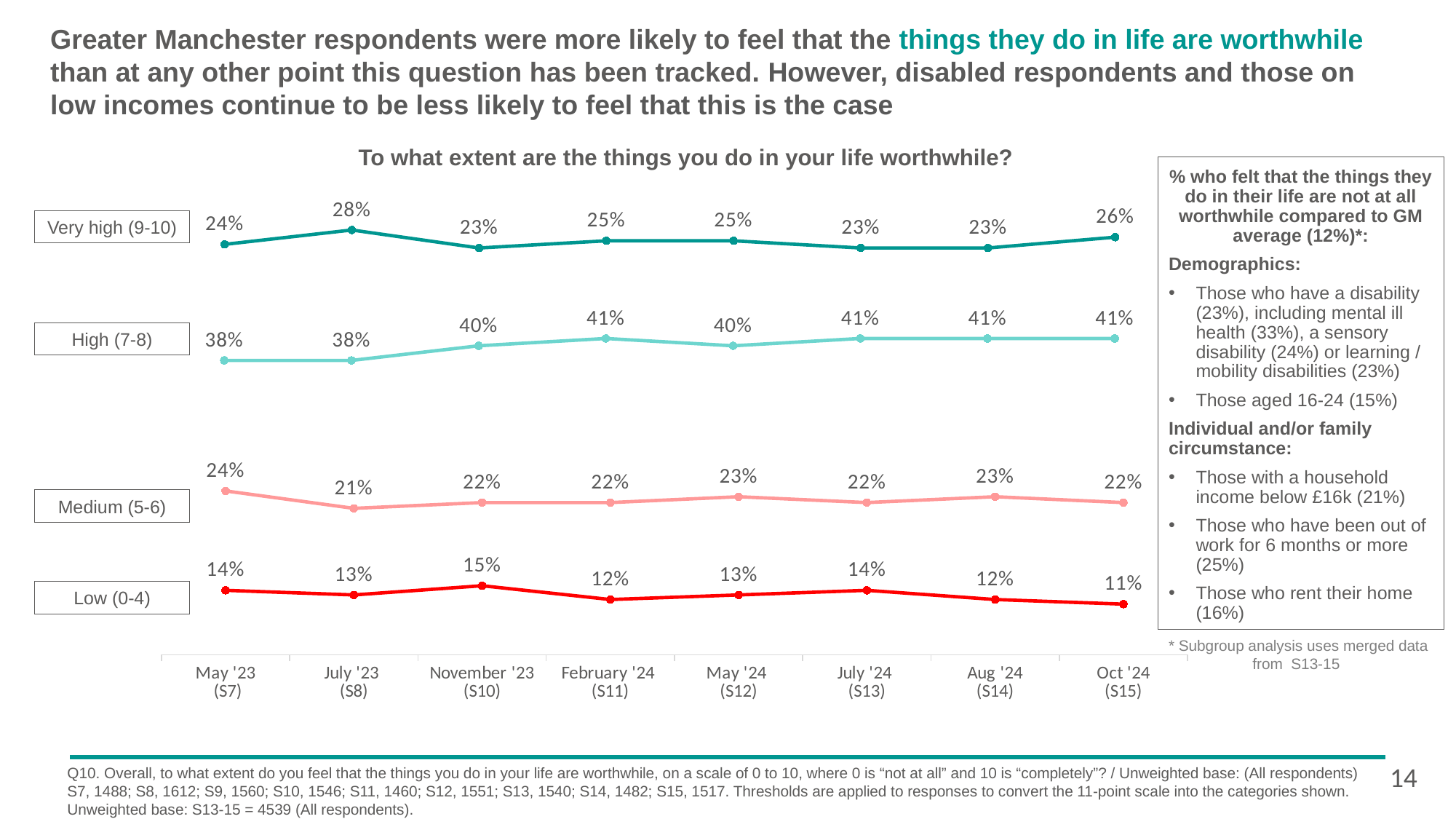
What kind of chart is used to show responses to "To what extent are the things you do in your life worthwhile?" Line chart What is the difference between the Medium (5-6) share in May '23 (S7) and in July '23 (S8)? 3 percentage points What is the difference between the High (7-8) share and the Very high (9-10) share in Oct '24 (S15)? 15 percentage points In which survey wave was the Low (0-4) share at its lowest? Oct '24 (S15) How many survey waves are plotted along the x axis? 8 Which was larger in July '23 (S8): the Medium (5-6) share or the Very high (9-10) share? Very high (9-10) What percentage of respondents gave a Very high (9-10) rating in Oct '24 (S15)? 26% How many response categories (lines) are plotted on the chart? 4 What percentage of respondents gave a Low (0-4) rating in November '23 (S10)? 15% What percentage of respondents gave a High (7-8) rating in May '23 (S7)? 38% In which survey wave was the Very high (9-10) share at its highest? July '23 (S8) Did the High (7-8) share rise or fall between May '23 (S7) and Oct '24 (S15)? Rise